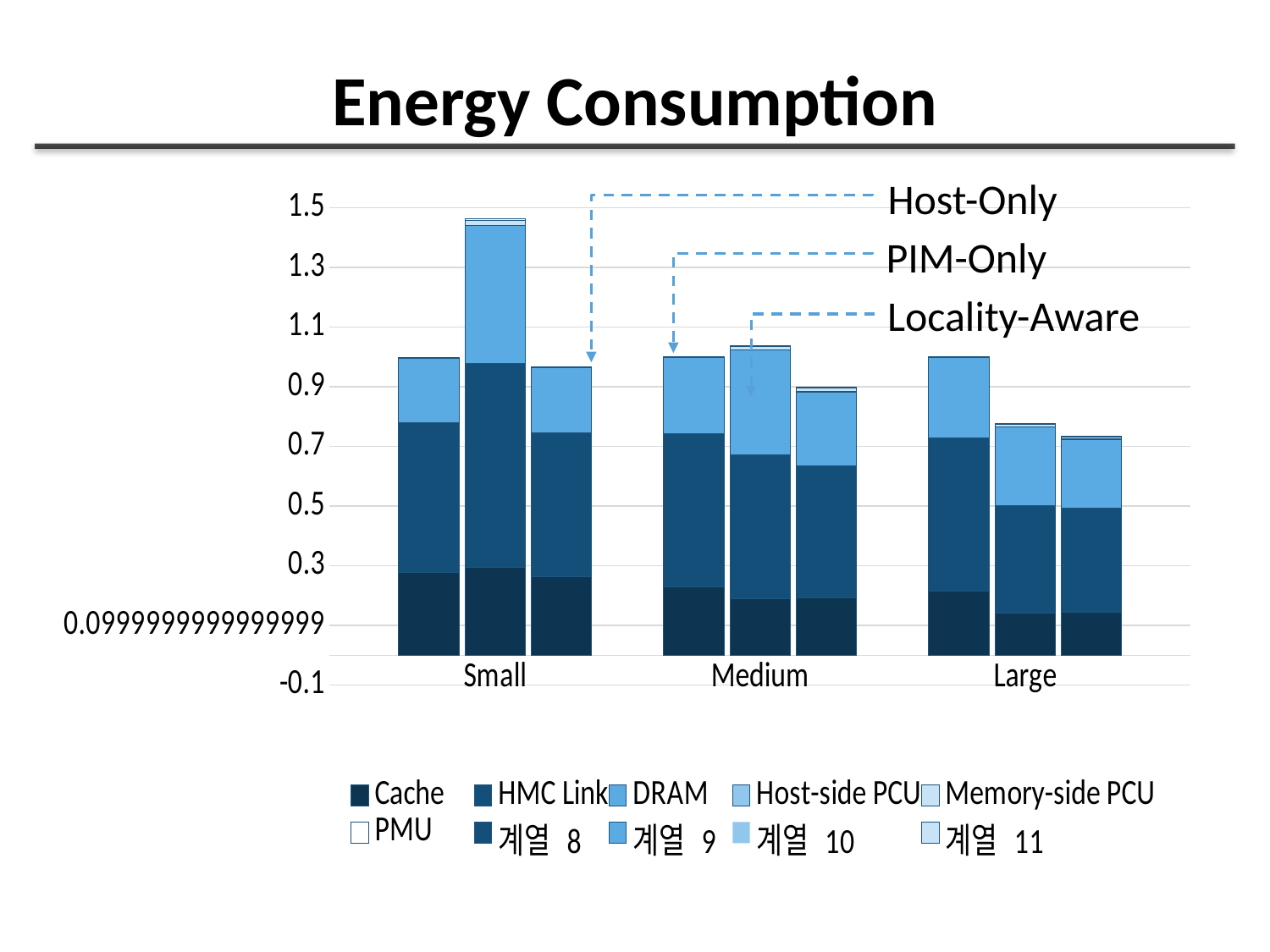
Is the PIM-Only bar for Small greater or less than 1.3? greater Which of the three configurations has the shortest bar in the Large category? Locality-Aware What kind of chart is shown on the slide? stacked bar chart Which is larger in the Medium category, the PIM-Only bar or the Locality-Aware bar? PIM-Only How many categories are shown on the x axis of the chart? 3 Do the PIM-Only bars rise or fall going from Small to Large? fall What is the title of the chart? Energy Consumption Is the Locality-Aware bar for Large greater or less than 0.9? less Is the PIM-Only bar for Large greater or less than 0.9? less Which series is listed first in the chart's legend? Cache How many series does the chart's legend list? 10 Which of the three configurations (Host-Only, PIM-Only, Locality-Aware) has the tallest bar in the Small category? PIM-Only